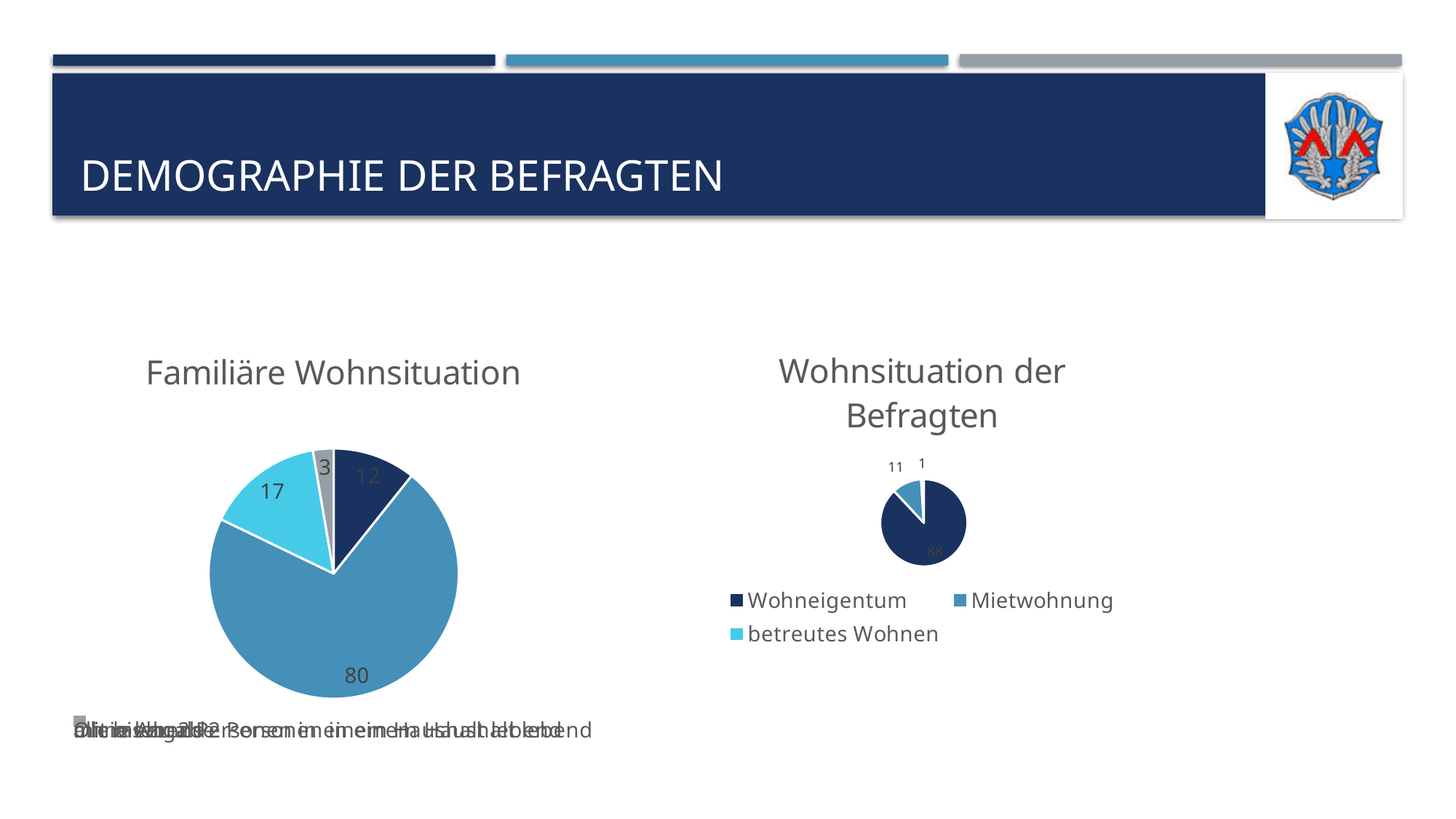
In the "Familiäre Wohnsituation" chart, what is the value of the largest slice? 80 In the "Wohnsituation der Befragten" chart, what is the value for Wohneigentum? 88 In the "Wohnsituation der Befragten" chart, what is the value for Mietwohnung? 11 In the "Wohnsituation der Befragten" chart, which category has the smallest slice? betreutes Wohnen In the "Familiäre Wohnsituation" chart, what is the difference between the largest slice (80) and the light blue slice (17)? 63 In the "Wohnsituation der Befragten" chart, which category has the largest slice? Wohneigentum In the "Wohnsituation der Befragten" chart, what is the value for betreutes Wohnen? 1 What kind of chart is the "Familiäre Wohnsituation" chart? pie chart In the "Wohnsituation der Befragten" chart, what is the difference between Wohneigentum and Mietwohnung? 77 In the "Wohnsituation der Befragten" chart, what share of the total does Wohneigentum represent? 88% How many slices does the "Familiäre Wohnsituation" pie chart have? 4 How many entries does the legend of the "Wohnsituation der Befragten" chart list? 3